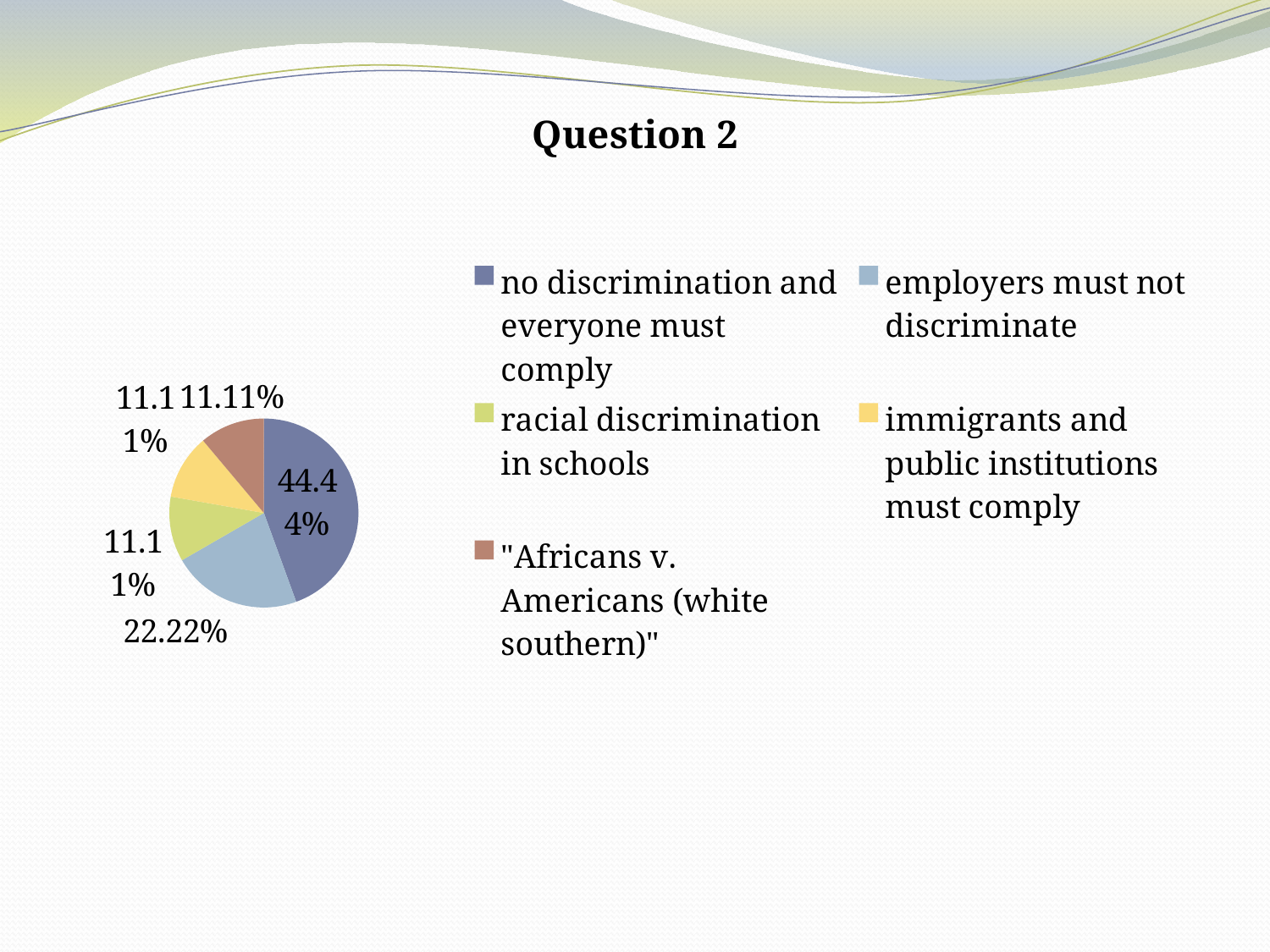
What colour is the slice for 'immigrants and public institutions must comply'? yellow What share of the pie is 'racial discrimination in schools'? 11.11% What is the difference between the shares for 'no discrimination and everyone must comply' and 'employers must not discriminate'? 22.22% What is the title of the chart? Question 2 How many entries does the legend list? 5 Which is larger: 'employers must not discriminate' or 'immigrants and public institutions must comply'? employers must not discriminate How many slices does the pie chart have? 5 Which category has the largest slice of the pie? no discrimination and everyone must comply What is the difference between the shares for 'employers must not discriminate' and 'racial discrimination in schools'? 11.11% What share of the pie is 'employers must not discriminate'? 22.22% What share of the pie is 'no discrimination and everyone must comply'? 44.44% What type of chart is shown on the slide? pie chart